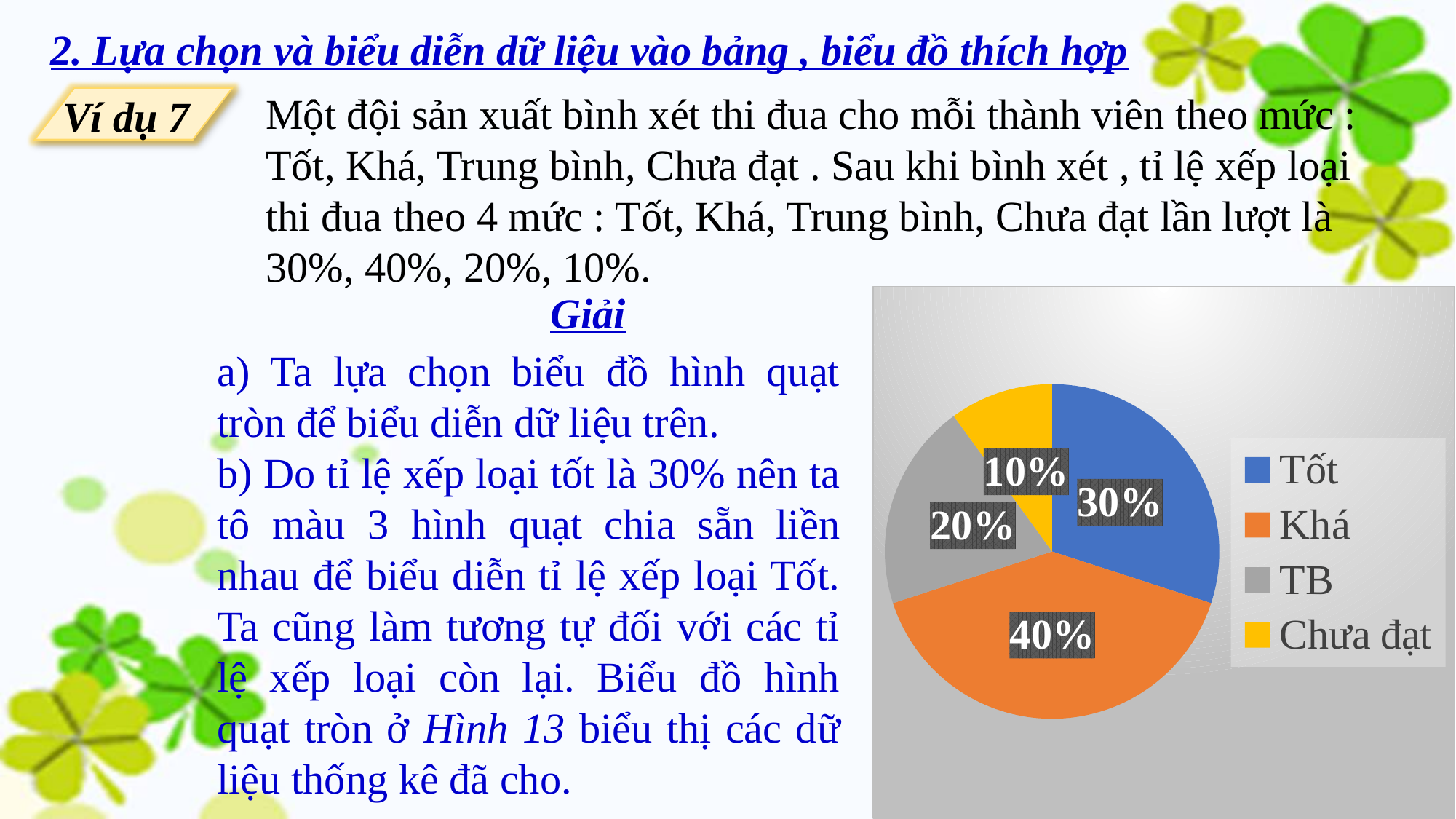
What percentage does the TB slice show? 20% How many entries does the legend list? 4 What colour is the Khá slice in the pie chart? orange What percentage does the Khá slice show? 40% Which is larger, the TB slice or the Chưa đạt slice? TB What kind of chart is shown on the slide? pie chart What percentage does the Chưa đạt slice show? 10% How many slices does the pie chart have? 4 Which category has the largest slice of the pie? Khá What percentage does the Tốt slice show? 30% Which category has the smallest slice of the pie? Chưa đạt What is the difference between the Khá and Tốt percentages? 10%